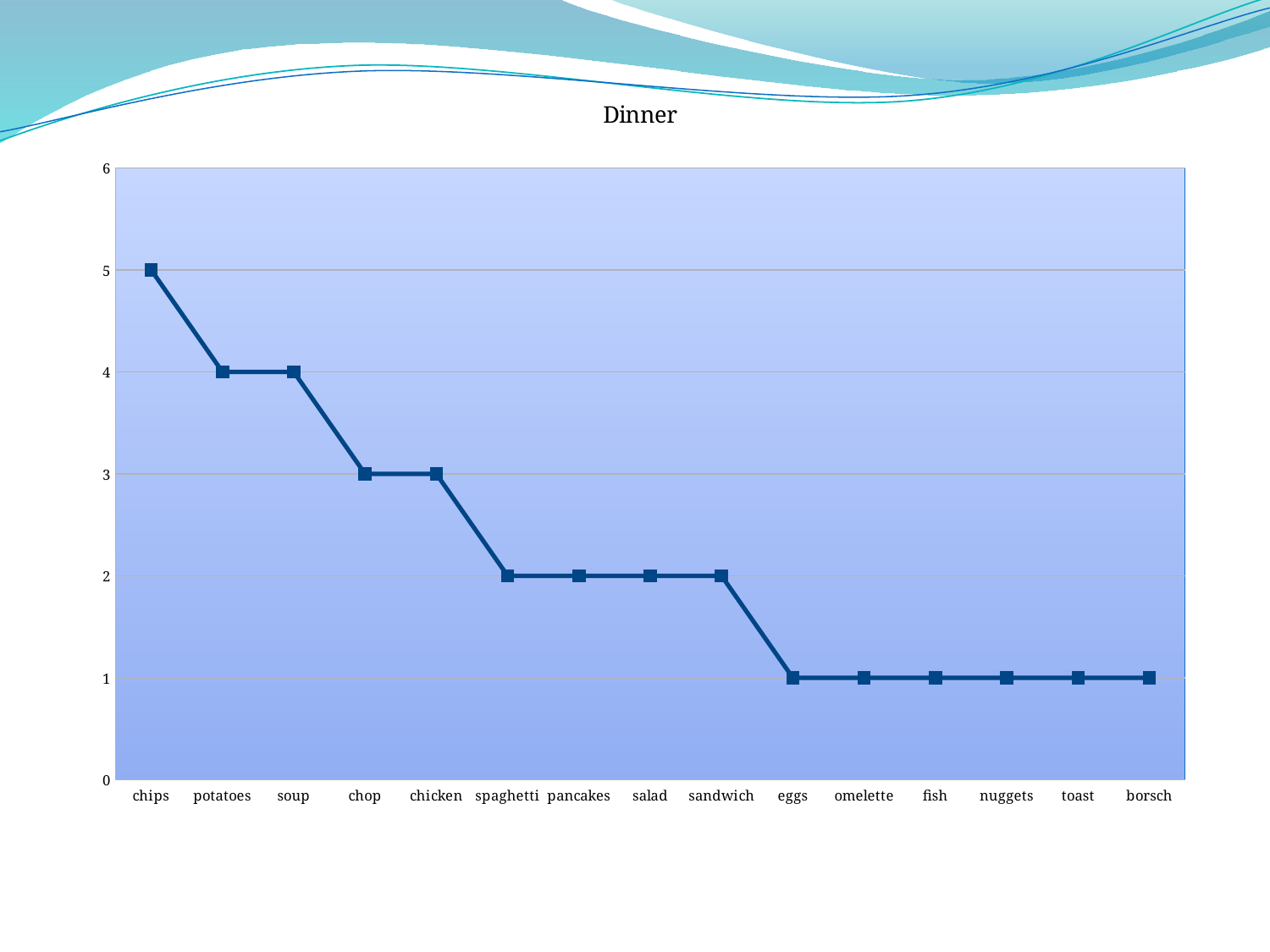
Is the value for potatoes greater or less than 3? greater What is the difference between the values for soup and eggs? 3 Which is larger, the value for chicken or the value for salad? chicken Do the values rise or fall from left to right along the x axis? fall What is the difference between the values for chips and potatoes? 1 Which category has the highest value? chips What is the value for spaghetti? 2 How many categories are shown on the x axis? 15 What is the value for chop? 3 What is the value for borsch? 1 What kind of chart is this? line chart What is the value for chips? 5